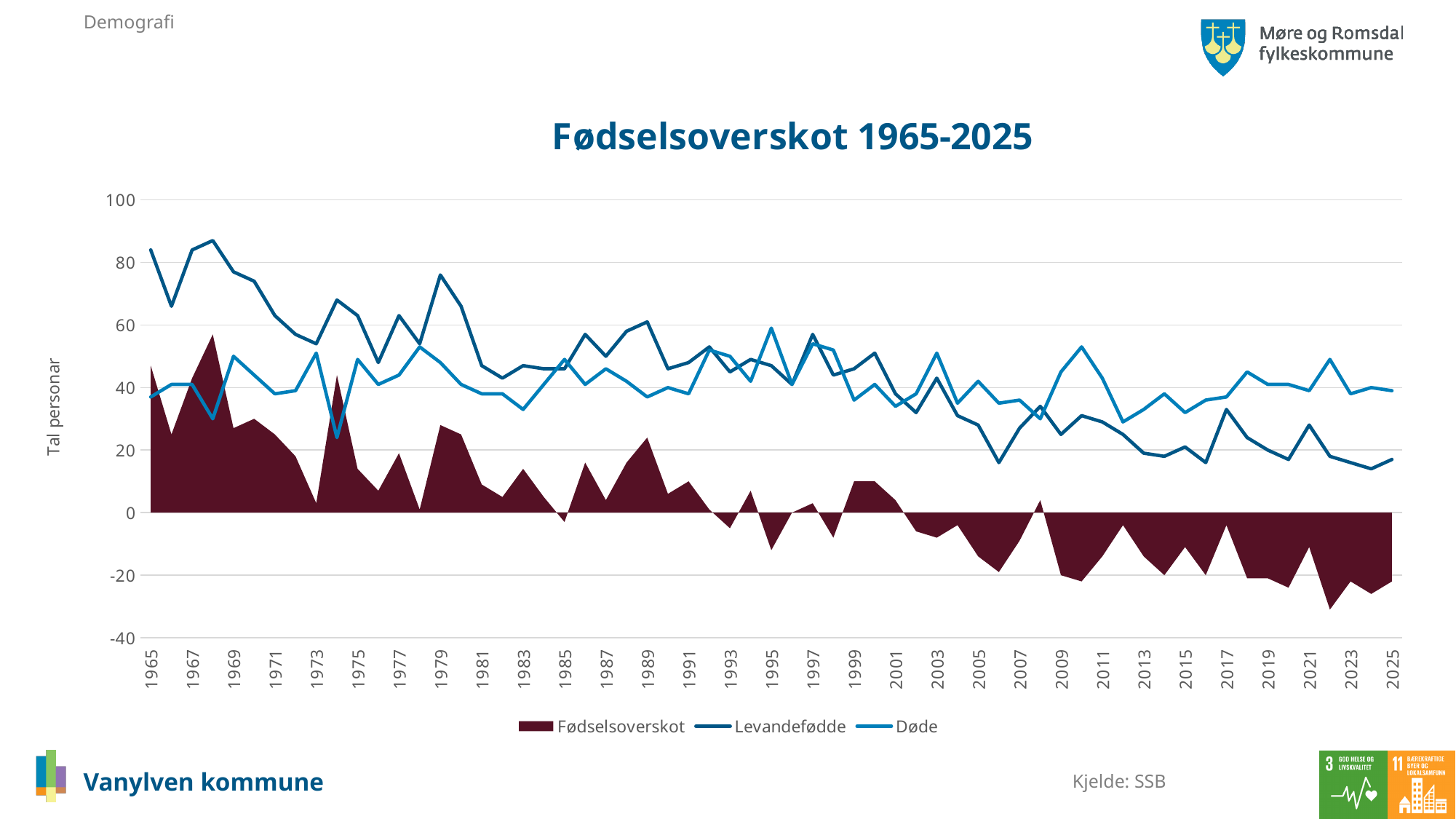
Is the value for Levandefødde in 1979 greater or less than 60? greater Is the value for Fødselsoverskot in 2022 greater or less than -20? less How many series does the legend list? 3 In 2025, which is larger: Levandefødde or Døde? Døde Does the Fødselsoverskot series rise or fall overall from 1965 to 2025? Falls What kind of chart is this? A combined area and line chart Is the value for Levandefødde in 1965 greater or less than 80? greater Does the Levandefødde series rise or fall overall from 1965 to 2025? Falls In 1965, which is larger: Levandefødde or Døde? Levandefødde What is the title of the chart? Fødselsoverskot 1965-2025